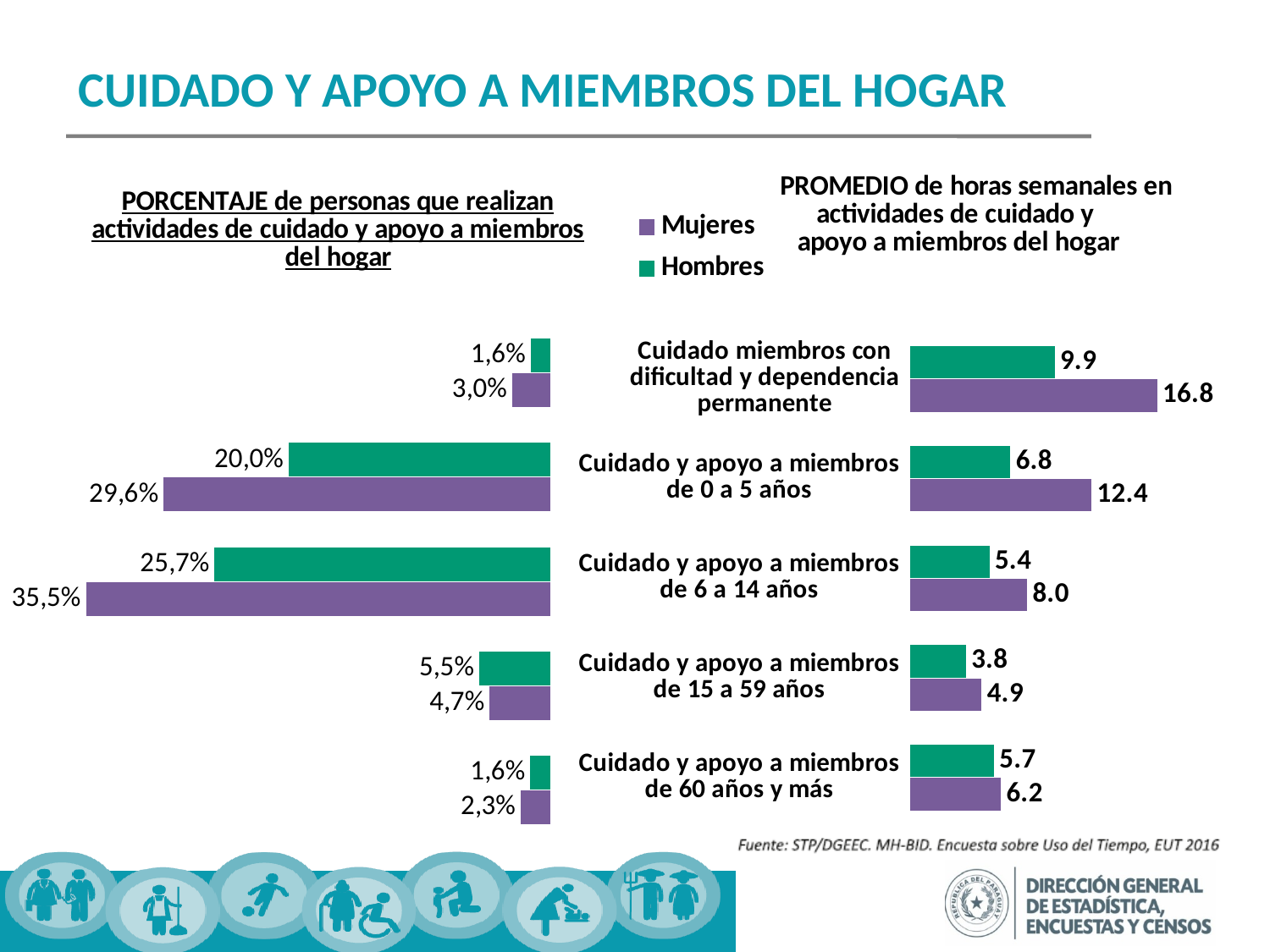
In the PORCENTAJE chart on the left, which category has the highest value for Mujeres? Cuidado y apoyo a miembros de 6 a 14 años In the PORCENTAJE chart on the left, what is the value for Mujeres for 'Cuidado y apoyo a miembros de 6 a 14 años'? 35,5% In the PROMEDIO de horas semanales chart on the right, what is the value for Hombres for 'Cuidado y apoyo a miembros de 15 a 59 años'? 3.8 In the PORCENTAJE chart on the left, what is the value for Hombres for 'Cuidado y apoyo a miembros de 0 a 5 años'? 20,0% How many series does the legend list? 2 In the PROMEDIO de horas semanales chart on the right, what is the difference between Mujeres and Hombres for 'Cuidado y apoyo a miembros de 0 a 5 años'? 5.6 In the PORCENTAJE chart on the left, which is larger for 'Cuidado y apoyo a miembros de 15 a 59 años', Mujeres or Hombres? Hombres How many categories are shown in the PROMEDIO de horas semanales chart on the right? 5 In the PROMEDIO de horas semanales chart on the right, which category has the lowest value for Hombres? Cuidado y apoyo a miembros de 15 a 59 años In the PROMEDIO de horas semanales chart on the right, what is the value for Mujeres for 'Cuidado miembros con dificultad y dependencia permanente'? 16.8 What kind of chart is the PORCENTAJE chart on the left? Bar chart In the PORCENTAJE chart on the left, what is the difference between Mujeres and Hombres for 'Cuidado y apoyo a miembros de 6 a 14 años'? 9,8%